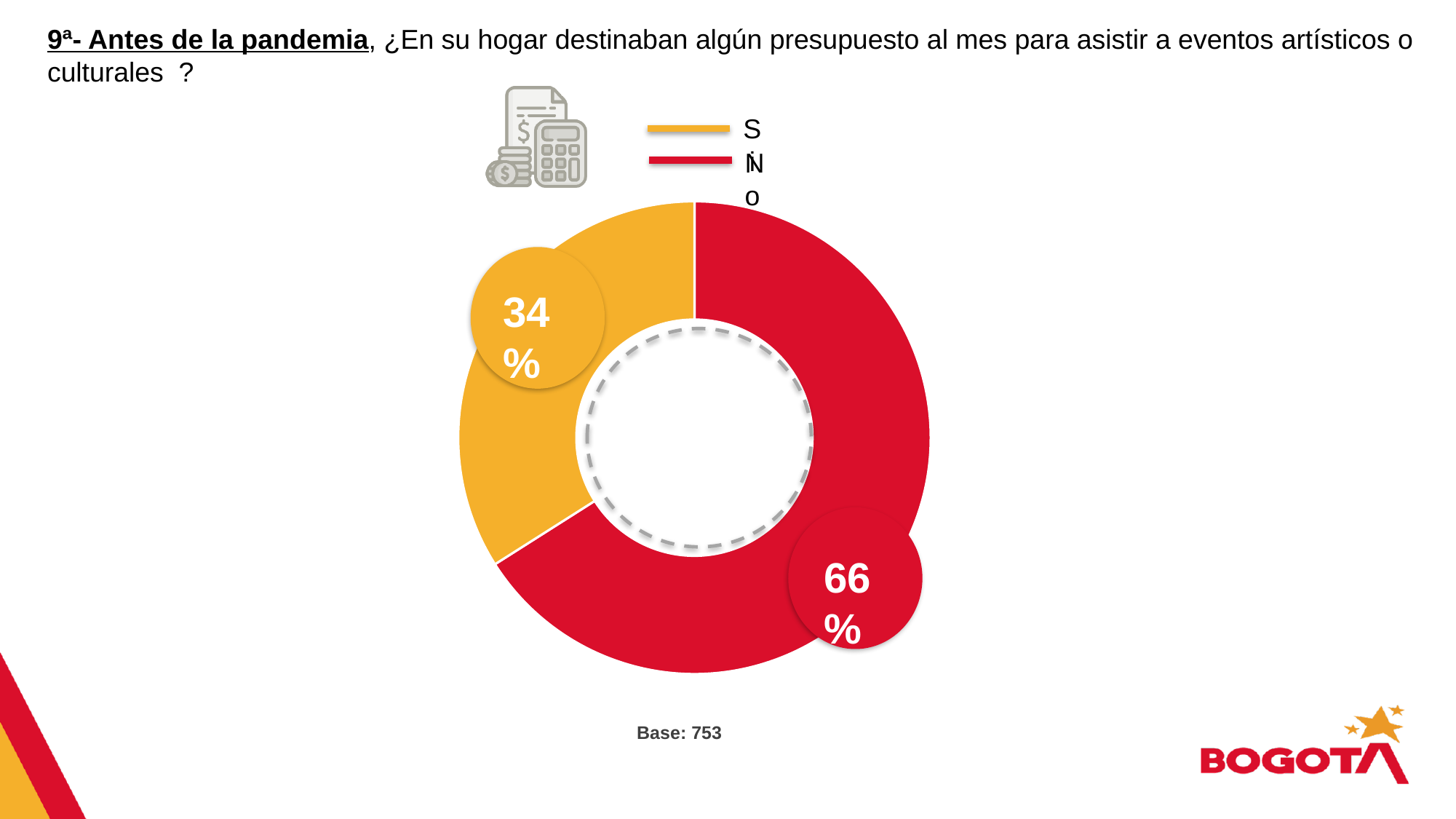
Which response has the largest share of the chart? No What kind of chart is shown on the slide? Pie chart (donut) Which is larger, the share for "Sí" or the share for "No"? No Which colour represents the "No" response in the chart? Red What percentage of respondents answered "Sí"? 34% Which response has the smallest share of the chart? Sí What is the base (number of respondents) shown below the chart? 753 How many categories are shown in the chart? 2 How many entries does the legend list? 2 What percentage of respondents answered "No"? 66% What is the difference in percentage points between the "No" and "Sí" responses? 32